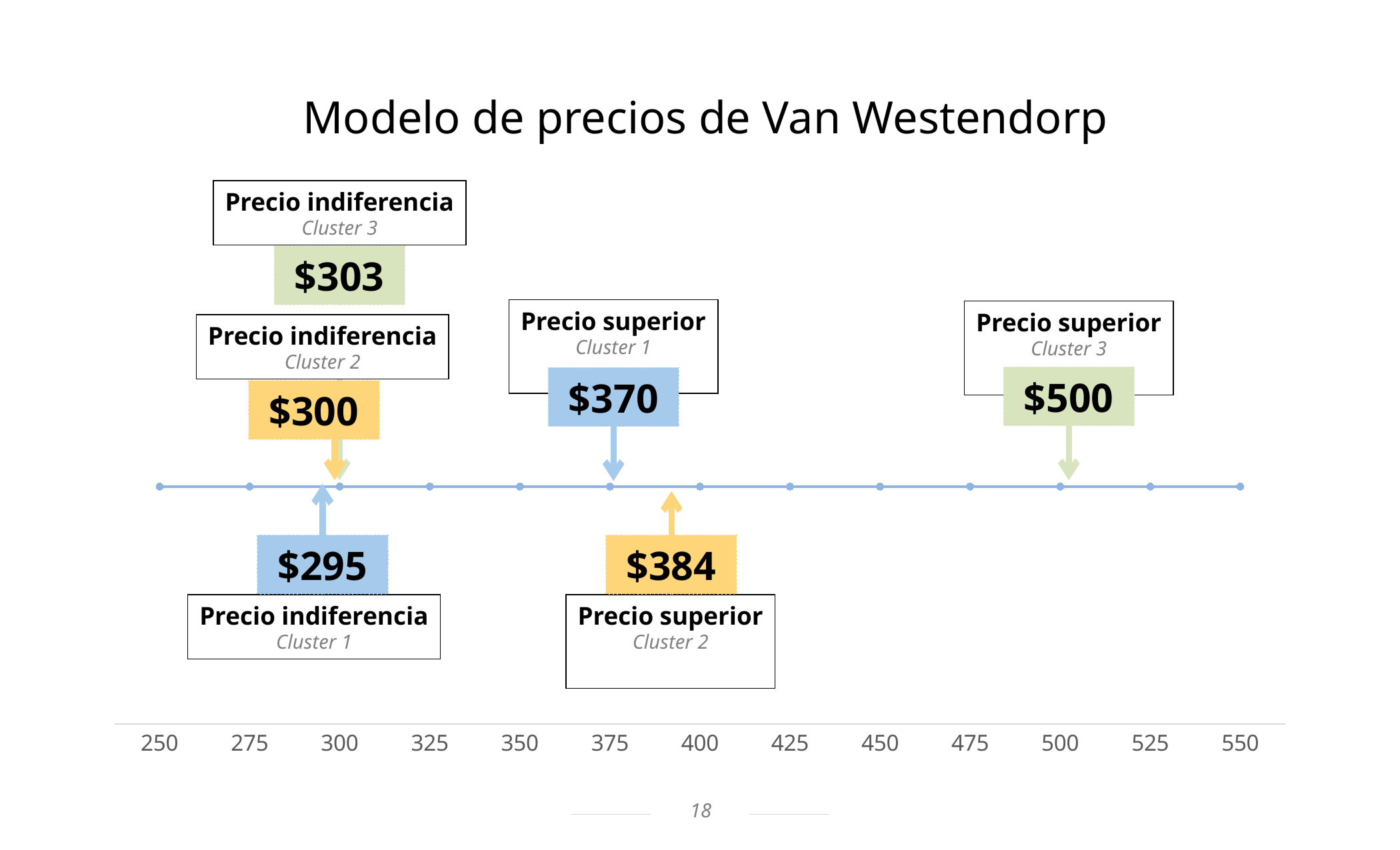
What is the difference between the Precio superior and the Precio indiferencia for Cluster 1? $75 What is the title of the chart? Modelo de precios de Van Westendorp What is the Precio superior for Cluster 3? $500 What is the difference between the Precio superior for Cluster 3 and the Precio superior for Cluster 2? $116 Which cluster has the highest Precio superior? Cluster 3 What is the lowest value shown on the horizontal axis? 250 Which cluster has the lowest Precio indiferencia? Cluster 1 What is the Precio indiferencia for Cluster 3? $303 What is the Precio superior for Cluster 2? $384 How many price points are marked on the chart? 6 What is the Precio indiferencia for Cluster 1? $295 Which is larger, the Precio indiferencia for Cluster 2 or the Precio indiferencia for Cluster 3? Precio indiferencia for Cluster 3